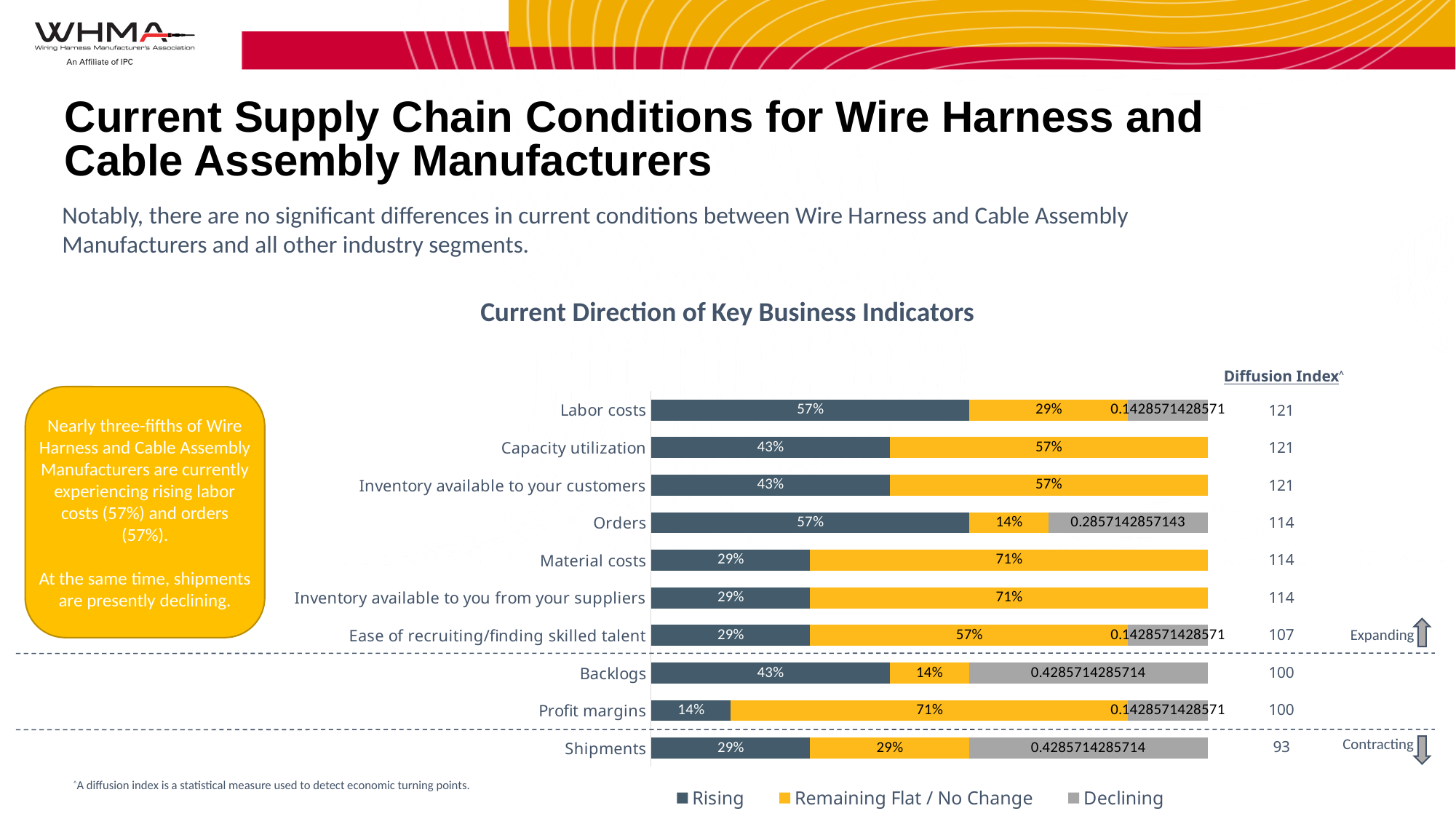
In the "Current Direction of Key Business Indicators" chart, which has a larger Rising share: Capacity utilization or Material costs? Capacity utilization In the "Current Direction of Key Business Indicators" chart, what is the Remaining Flat / No Change value for Material costs? 71% What are the three legend entries of the "Current Direction of Key Business Indicators" chart? Rising, Remaining Flat / No Change, Declining How many business indicators (categories) are plotted in the "Current Direction of Key Business Indicators" chart? 10 In the "Current Direction of Key Business Indicators" chart, which indicator has the lowest Rising percentage? Profit margins In the "Current Direction of Key Business Indicators" chart, what value is printed on the Declining segment for Backlogs? 0.4285714285714 In the "Current Direction of Key Business Indicators" chart, what is the difference between the Remaining Flat / No Change values for Material costs and Labor costs? 42% In the "Current Direction of Key Business Indicators" chart, what is the Rising value for Profit margins? 14% How many series does the legend of the "Current Direction of Key Business Indicators" chart list? 3 What type of chart is shown under the title "Current Direction of Key Business Indicators"? Bar chart What Diffusion Index value is shown for Shipments on the slide? 93 In the "Current Direction of Key Business Indicators" chart, what percentage of respondents report Labor costs as Rising? 57%